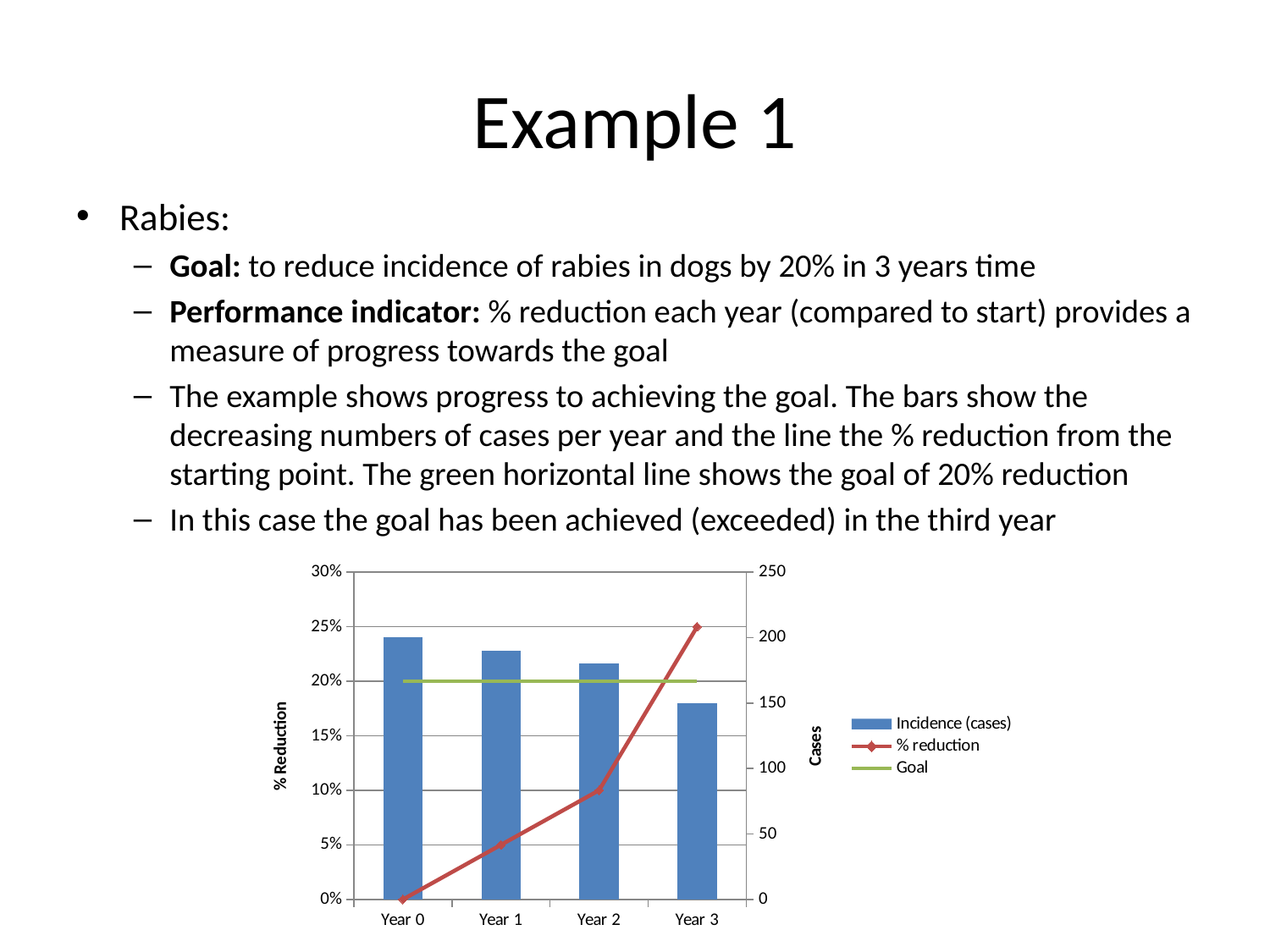
How many series does the chart legend list? 3 What is the % reduction value for Year 3? 25% What is the % reduction value for Year 0? 0% Which year has the lowest number of incidence cases? Year 3 How many year categories are shown on the x axis? 4 At what % reduction level is the Goal line drawn? 20% Do the incidence (cases) bars rise or fall from Year 0 to Year 3? fall Which is larger, the % reduction for Year 3 or the Goal line? % reduction for Year 3 Which year has the highest number of incidence cases? Year 0 Is the number of incidence cases for Year 2 greater or less than 200? less Is the number of incidence cases for Year 1 greater or less than 150? greater What kind of chart is shown on the slide? A combined bar and line chart